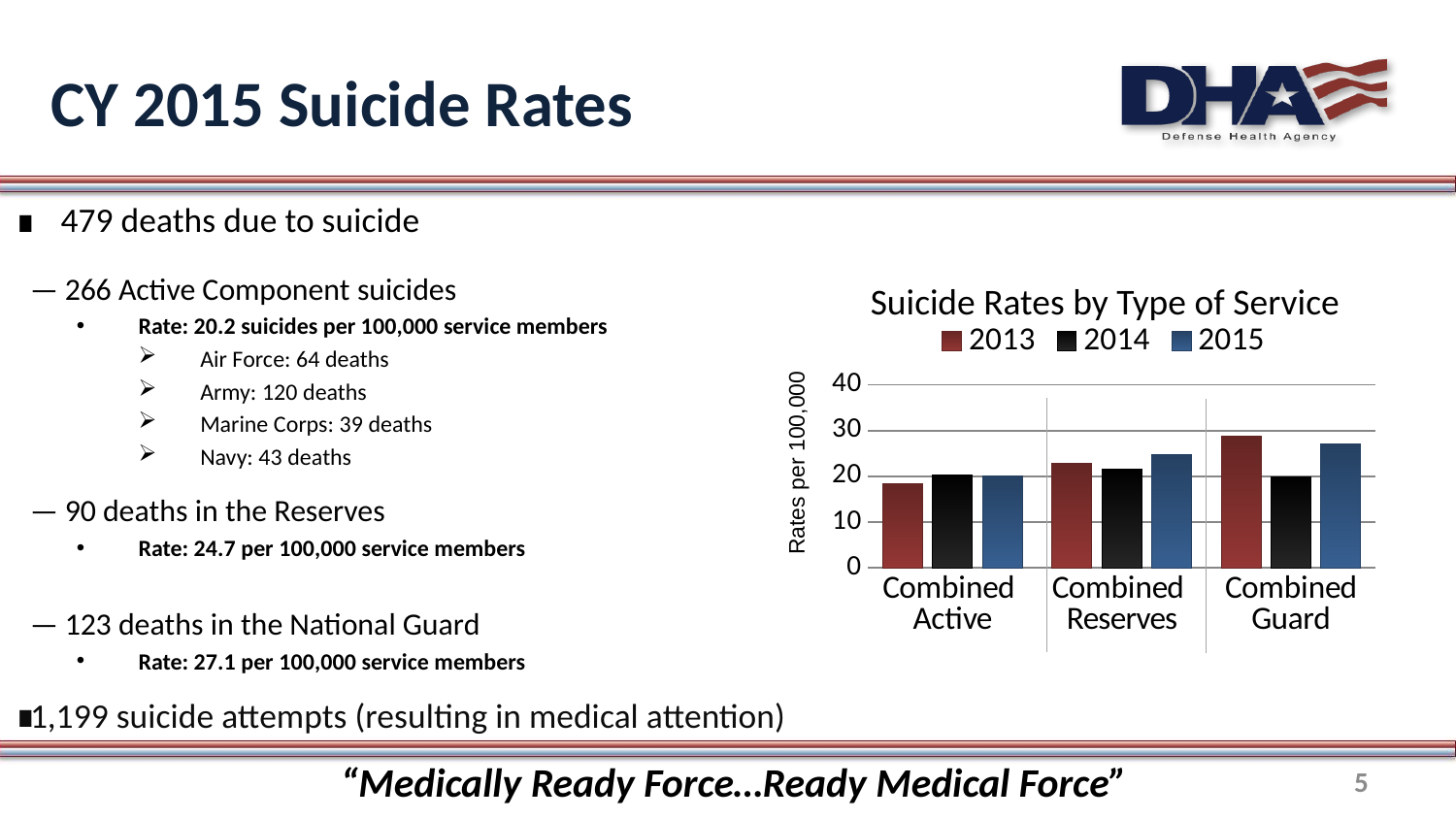
How many series does the legend of the chart list? 3 Which category has the highest 2013 value? Combined Guard For Combined Guard, which is larger: the 2013 value or the 2014 value? 2013 Is the 2013 value for Combined Guard greater or less than 20? greater What kind of chart is shown on the slide? bar chart Which category has the lowest 2013 value? Combined Active Which is larger: the 2015 value for Combined Reserves or the 2015 value for Combined Active? Combined Reserves How many categories are shown on the x axis of the chart? 3 What is the title of the chart? Suicide Rates by Type of Service Is the 2015 value for Combined Reserves greater or less than 30? less Is the 2013 value for Combined Active greater or less than 20? less What are the legend entries of the chart? 2013, 2014, 2015